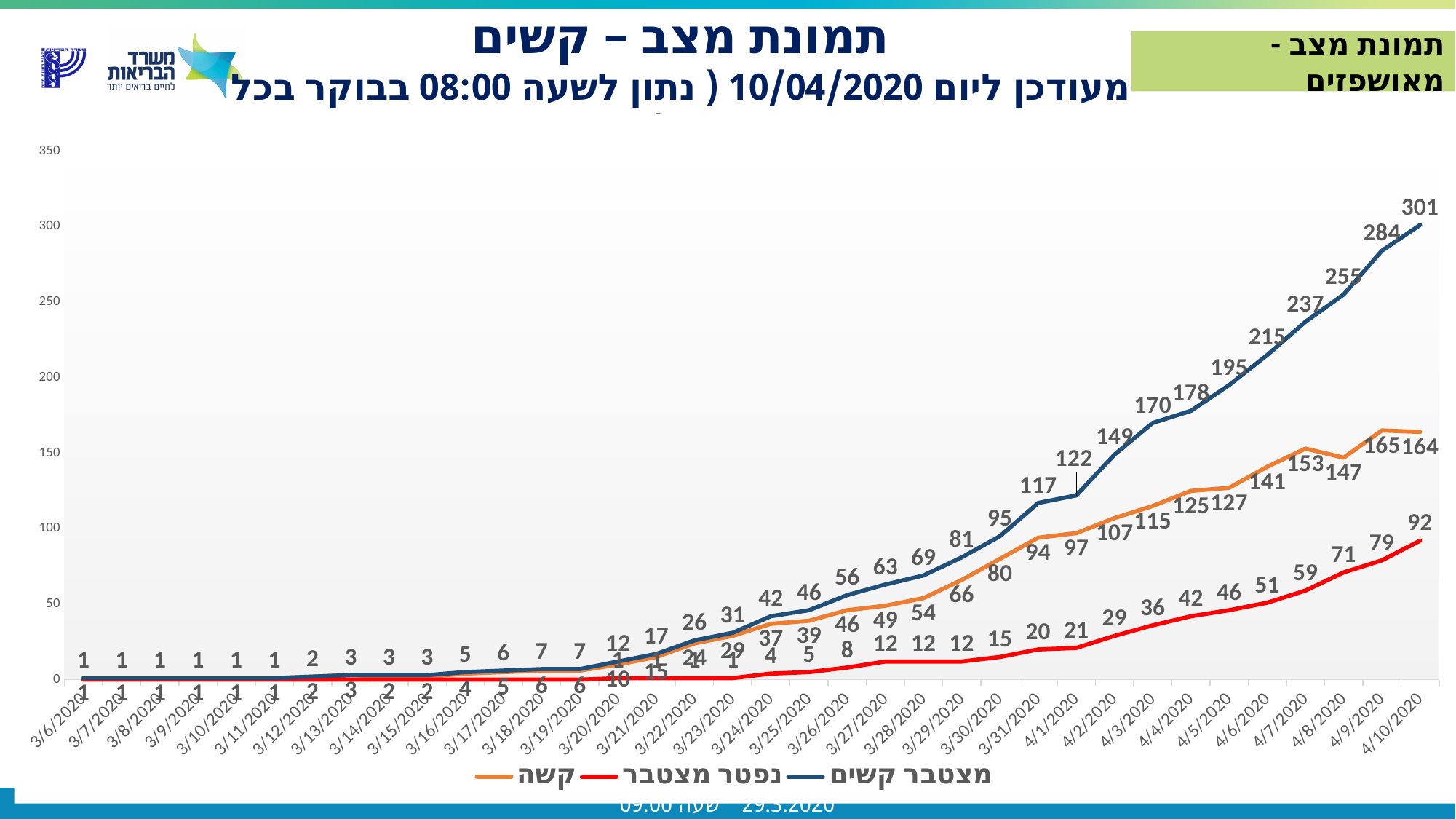
What is the value of קשה on 4/9/2020? 165 What is the value of מצטבר קשים on 4/10/2020? 301 On 4/10/2020, which is larger: קשה or נפטר מצטבר? קשה What is the value of נפטר מצטבר on 4/5/2020? 46 How many series does the legend list? 3 On which date does מצטבר קשים reach its highest value? 4/10/2020 What kind of chart is shown on the slide? line chart How many dates are shown on the x axis? 36 What is the value of נפטר מצטבר on 4/10/2020? 92 By how much did מצטבר קשים increase from 4/9/2020 to 4/10/2020? 17 Does the מצטבר קשים series rise or fall over the dates shown? rise What is the value of מצטבר קשים on 4/1/2020? 122